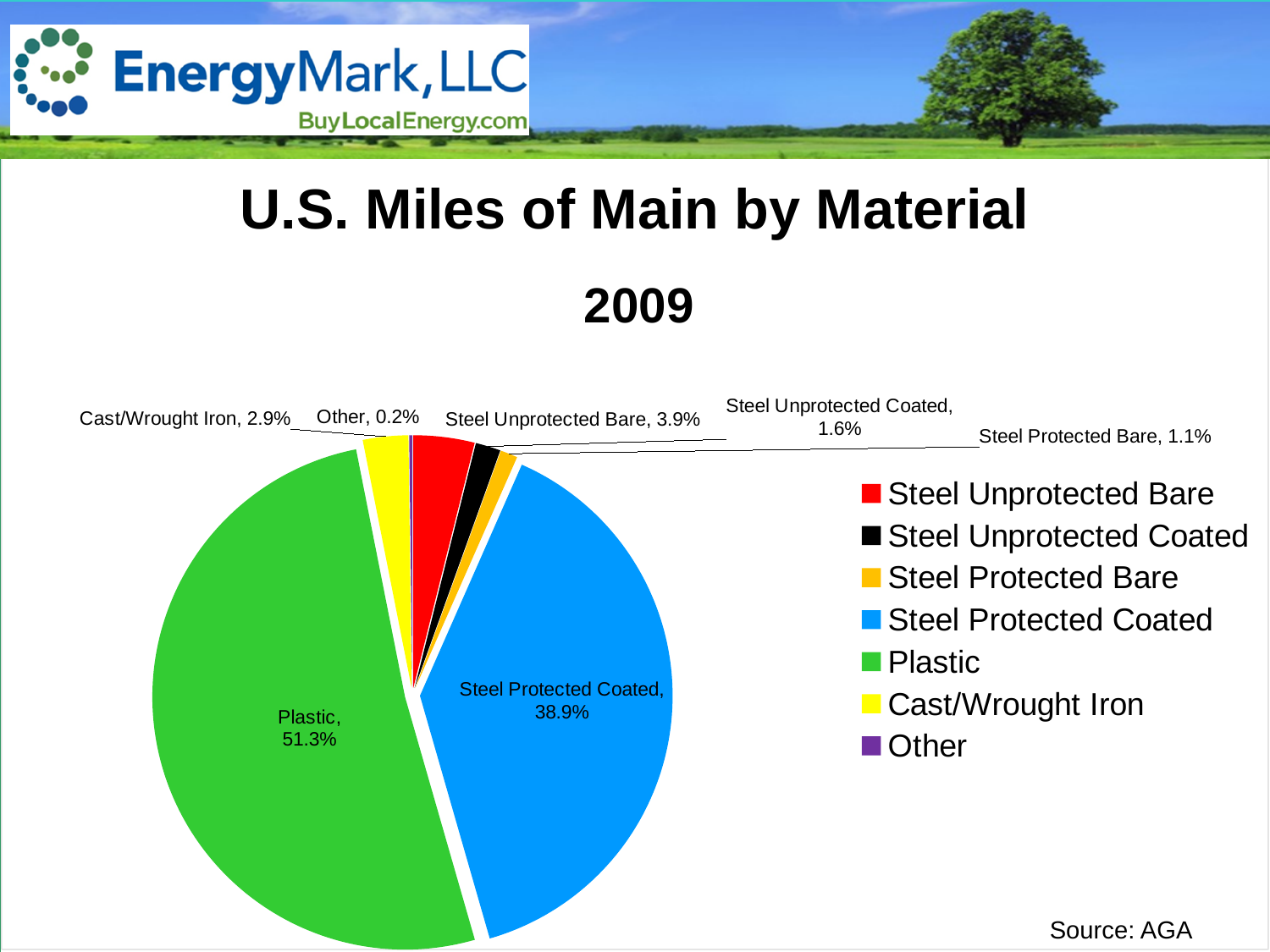
What share of U.S. miles of main is Steel Protected Bare? 1.1% Which material has the smallest share of U.S. miles of main? Other Which material has the largest share of U.S. miles of main? Plastic How many material categories are shown in the pie chart? 7 What share of U.S. miles of main is Steel Unprotected Bare? 3.9% What kind of chart is shown on the slide? Pie chart What is the difference in percentage points between the Plastic and Steel Protected Coated shares? 12.4 What colour represents Cast/Wrought Iron in the pie chart? Yellow What share of U.S. miles of main is Plastic? 51.3% Which has a larger share, Steel Unprotected Coated or Steel Protected Bare? Steel Unprotected Coated What share of U.S. miles of main is Steel Protected Coated? 38.9% What share of U.S. miles of main is Cast/Wrought Iron? 2.9%